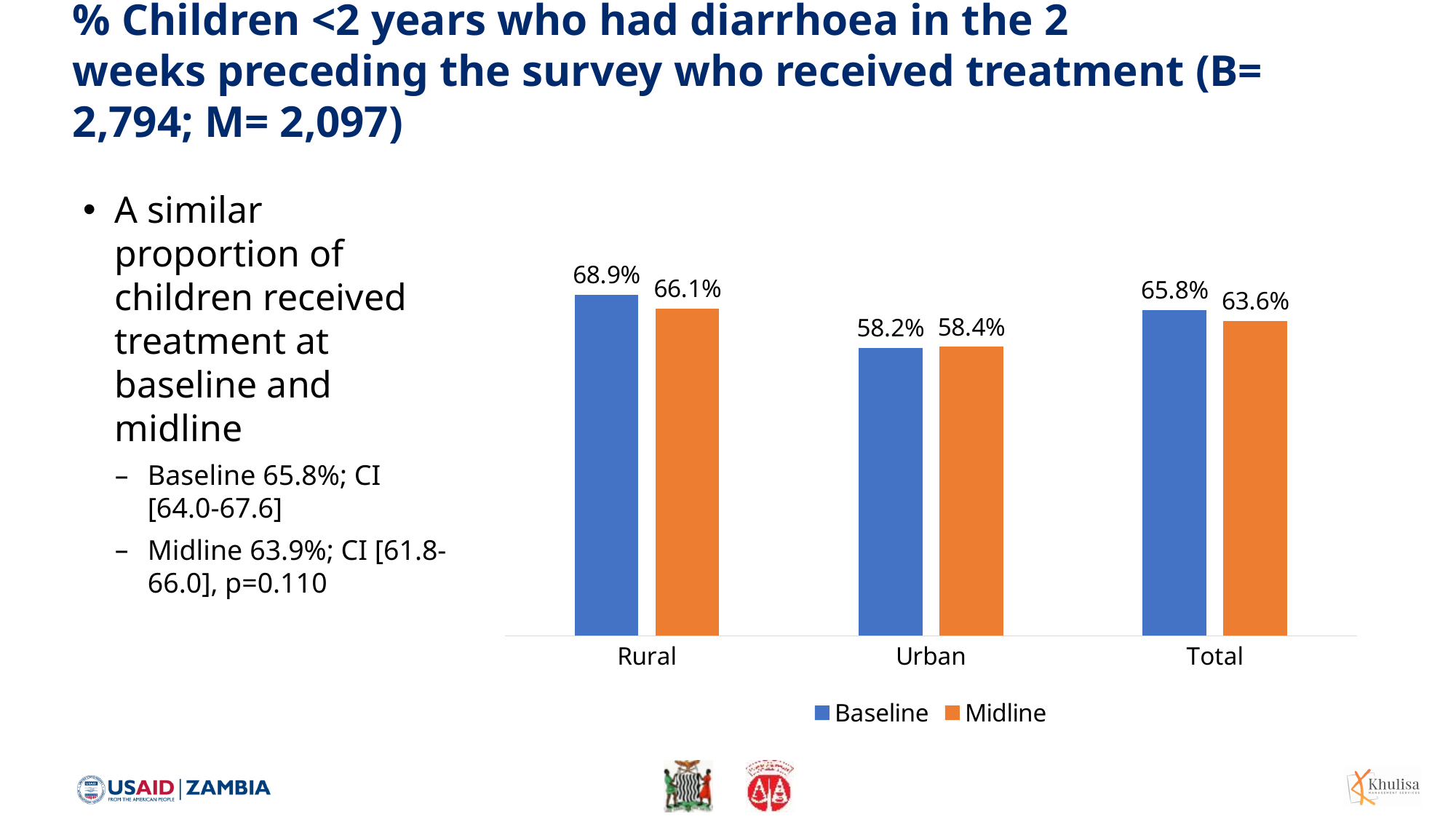
What is the Baseline value for Rural? 68.9% What is the Baseline value for Total? 65.8% Which category has the lowest Midline value? Urban What is the Midline value for Urban? 58.4% Which category has the highest Baseline value? Rural How many series does the legend list? 2 What kind of chart is shown on the slide? Bar chart What is the Midline value for Total? 63.6% How many categories are shown on the x axis? 3 What is the difference between the Baseline and Midline values for Rural? 2.8% What is the difference between the Rural and Urban Baseline values? 10.7% Which is larger, the Baseline value for Rural or the Baseline value for Urban? Rural